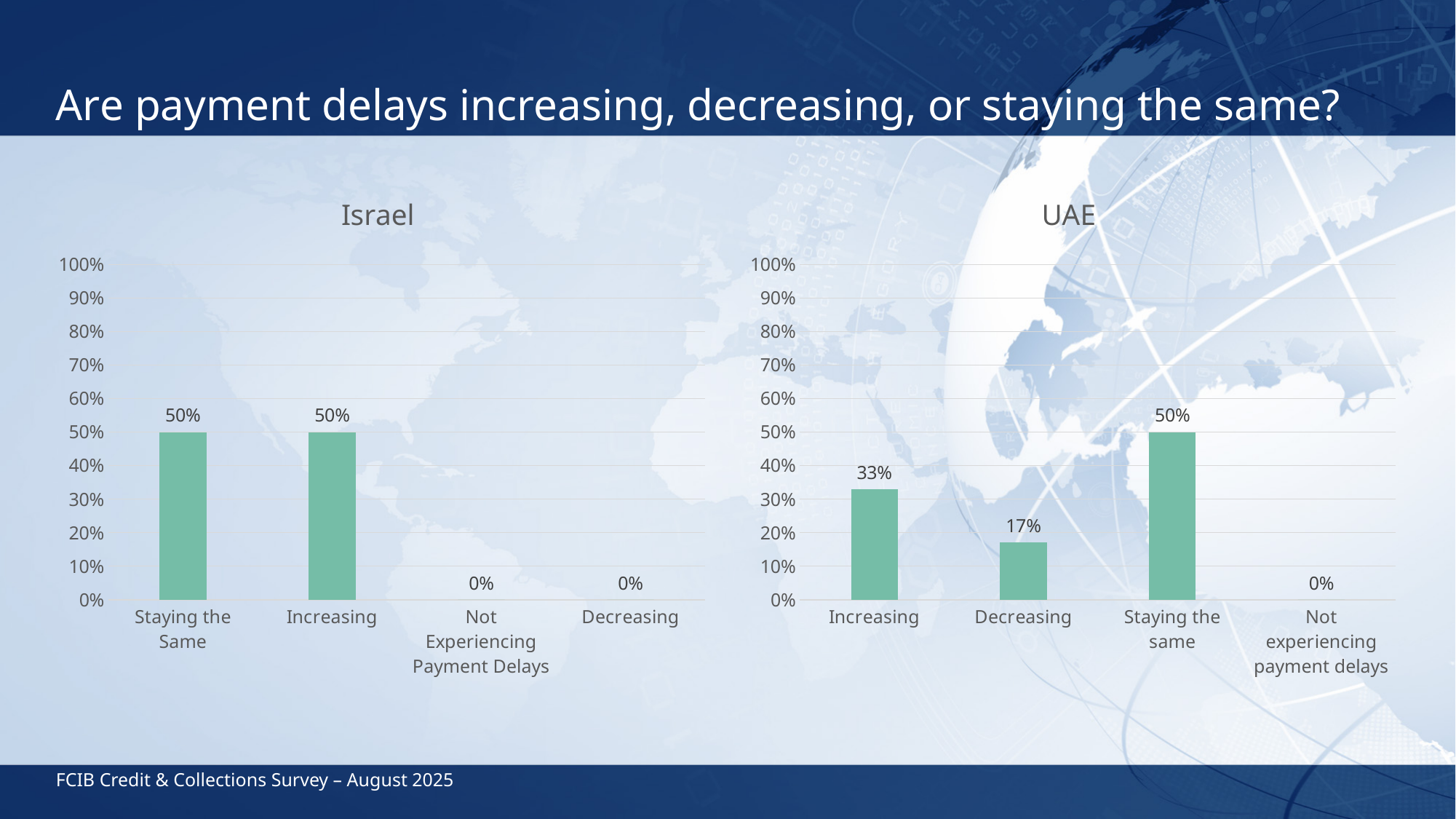
In the UAE chart, which category has the lowest value? Not experiencing payment delays In the UAE chart, what is the difference between Staying the same and Increasing? 17% In the UAE chart, which category has the highest value? Staying the same In the Israel chart, how many categories are shown on the x axis? 4 In the Israel chart, what is the difference between Staying the Same and Decreasing? 50% In the UAE chart, which is larger, Increasing or Decreasing? Increasing In the Israel chart, what is the value for Not Experiencing Payment Delays? 0% In the UAE chart, what is the value for Decreasing? 17% In the UAE chart, what is the value for Increasing? 33% In the Israel chart, what is the value for Increasing? 50% What is the title of the chart on the left? Israel What kind of chart is the UAE chart? Bar chart